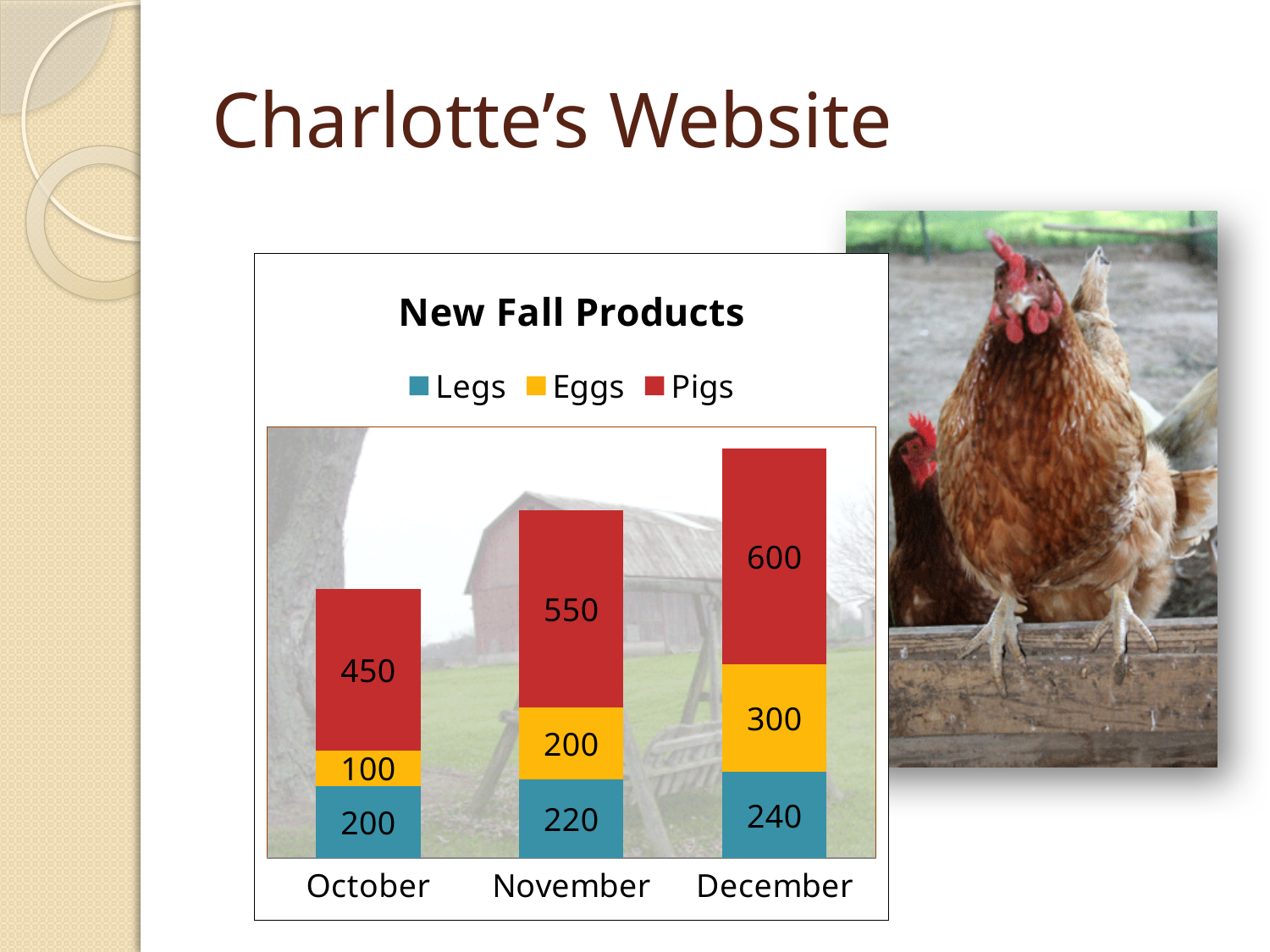
How many series does the legend list? 3 What is the value for Eggs in December? 300 What is the title of the chart? New Fall Products What is the value for Legs in October? 200 What is the total of the stacked bar for December? 1140 What is the value for Pigs in November? 550 Which is larger, the Eggs value in November or the Legs value in November? Legs in November What is the difference between the Pigs values for December and October? 150 What kind of chart is shown? Stacked bar chart Which month has the highest value for Pigs? December Which month has the lowest value for Eggs? October How many months are shown on the x axis? 3